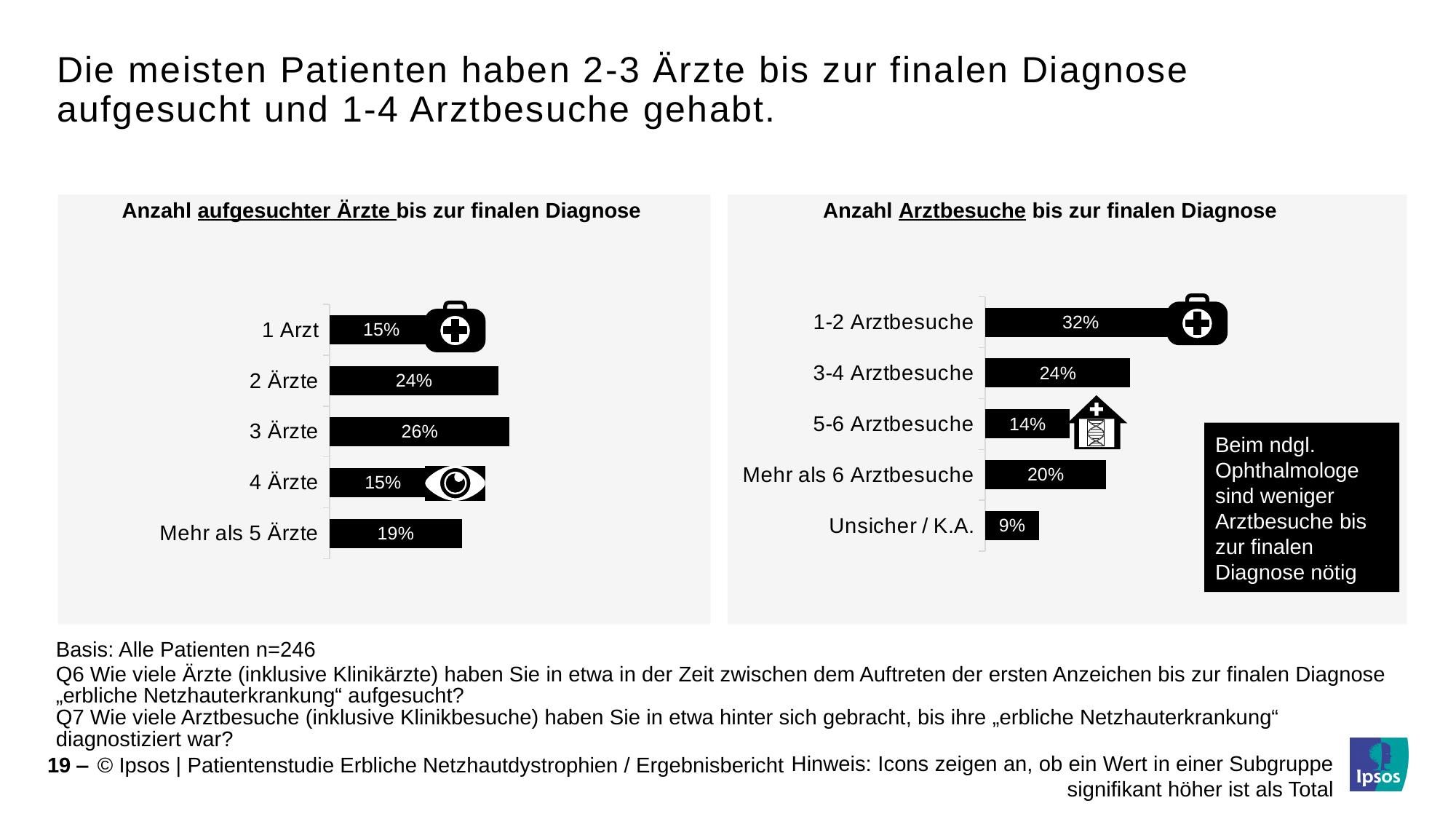
In the chart 'Anzahl Arztbesuche bis zur finalen Diagnose', what is the value for 'Unsicher / K.A.'? 9% In the chart 'Anzahl aufgesuchter Ärzte bis zur finalen Diagnose', what is the value for 'Mehr als 5 Ärzte'? 19% In the chart 'Anzahl aufgesuchter Ärzte bis zur finalen Diagnose', which category has the highest value? 3 Ärzte In the chart 'Anzahl Arztbesuche bis zur finalen Diagnose', which is larger: '5-6 Arztbesuche' or 'Mehr als 6 Arztbesuche'? Mehr als 6 Arztbesuche In the chart 'Anzahl aufgesuchter Ärzte bis zur finalen Diagnose', how many categories are shown? 5 In the chart 'Anzahl aufgesuchter Ärzte bis zur finalen Diagnose', what is the difference between '2 Ärzte' and '1 Arzt'? 9% In the chart 'Anzahl aufgesuchter Ärzte bis zur finalen Diagnose', what is the value for '3 Ärzte'? 26% In the chart 'Anzahl Arztbesuche bis zur finalen Diagnose', what is the difference between '1-2 Arztbesuche' and '3-4 Arztbesuche'? 8% In the chart 'Anzahl Arztbesuche bis zur finalen Diagnose', how many categories are shown? 5 In the chart 'Anzahl Arztbesuche bis zur finalen Diagnose', what is the value for '1-2 Arztbesuche'? 32% In the chart 'Anzahl Arztbesuche bis zur finalen Diagnose', which category has the lowest value? Unsicher / K.A. What type of chart is 'Anzahl Arztbesuche bis zur finalen Diagnose'? Bar chart